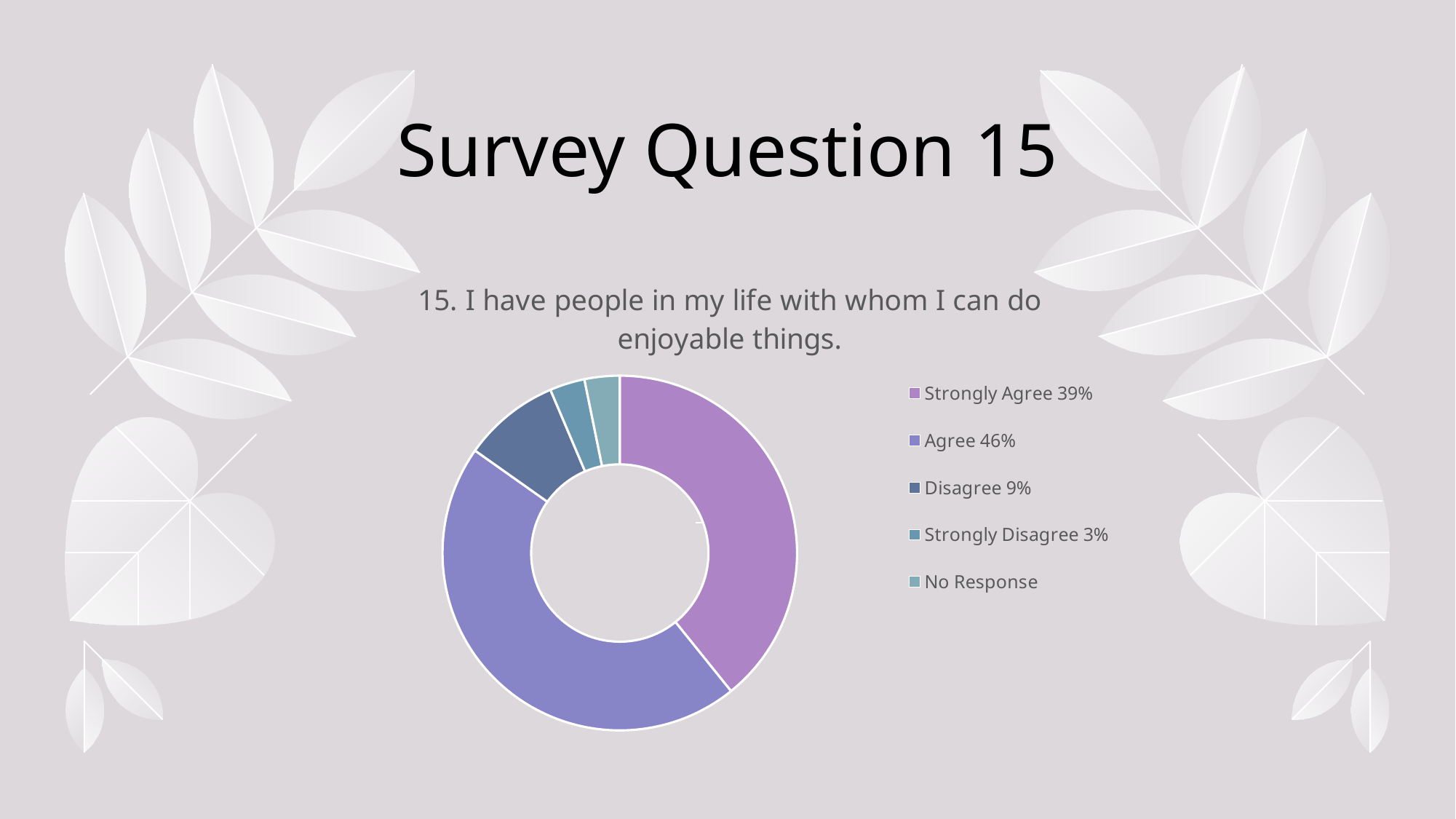
What percentage of respondents chose Disagree? 9% Which is larger, the share for Disagree or the share for Strongly Disagree? Disagree What percentage of respondents chose Strongly Agree? 39% What percentage of respondents chose Agree for survey question 15? 46% Which response category has the largest share of the chart? Agree What is the difference in percentage points between Agree and Strongly Agree? 7% What is the combined percentage of respondents who chose Strongly Agree or Agree? 85% What is the difference in percentage points between Strongly Agree and Disagree? 30% How many response categories does the legend list? 5 What kind of chart is shown on the slide? Doughnut chart What percentage of respondents chose Strongly Disagree? 3% Which is larger, the share for Strongly Agree or the share for Disagree? Strongly Agree